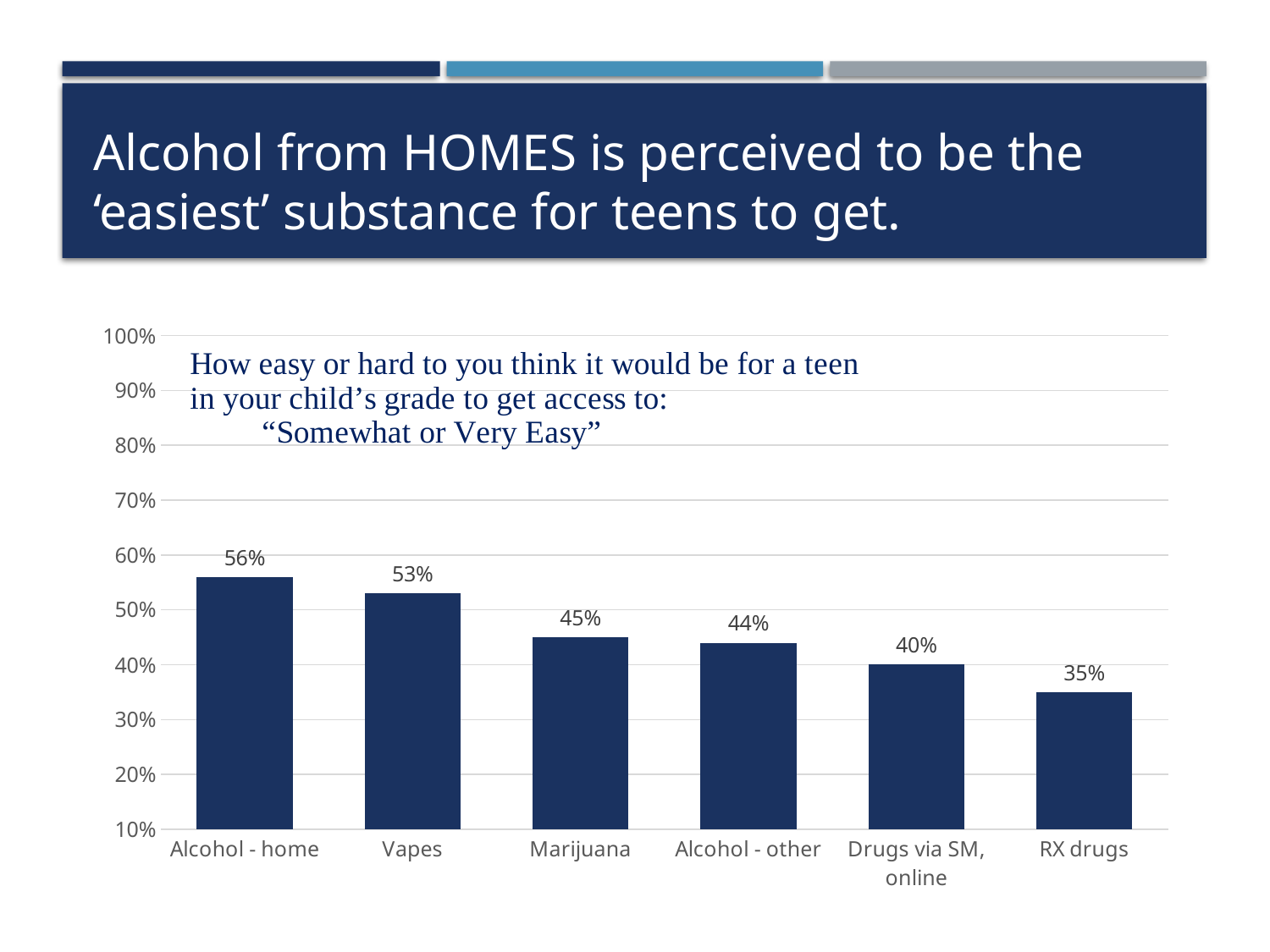
What is the difference between the values for Alcohol - home and RX drugs? 21% What is the value shown for Drugs via SM, online? 40% Do the values rise or fall moving from left to right across the categories? Fall What is the difference between the values for Vapes and Marijuana? 8% What percentage of respondents said it would be somewhat or very easy for a teen to get alcohol from home? 56% Which category has the lowest value? RX drugs How many categories are shown on the chart? 6 What kind of chart is shown on the slide? Bar chart Which category has the highest value? Alcohol - home What is the value shown for Vapes? 53% What is the value shown for Marijuana? 45% Which is larger, the value for Marijuana or the value for Alcohol - other? Marijuana